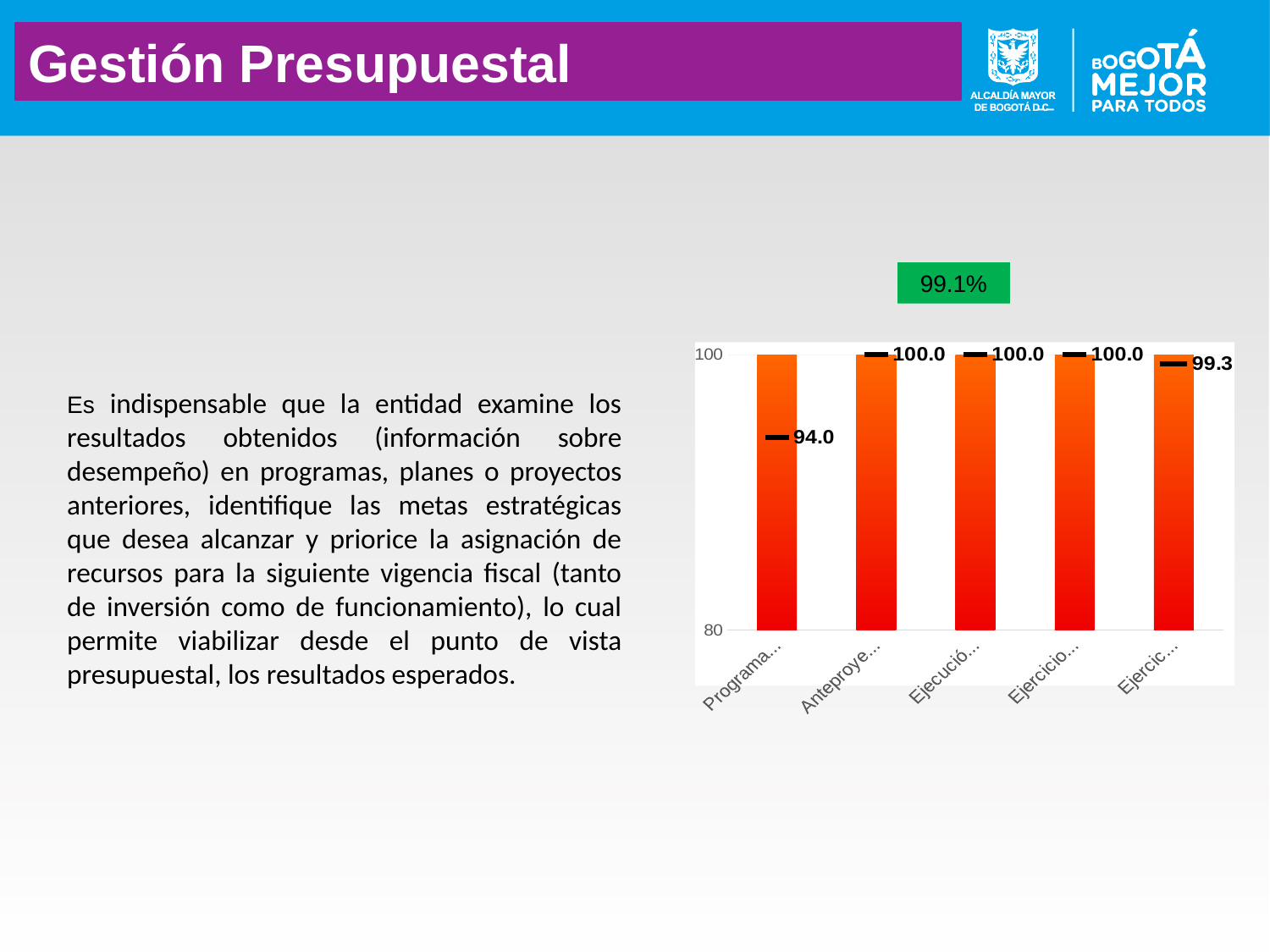
Which bar has the lowest value? the first bar (Programa...) Which is larger, the value of the first bar or the value of the last bar? the last bar What is the lowest value shown on the vertical axis? 80 What is the difference between the value of the fourth bar (100.0) and the last bar (99.3)? 0.7 What percentage is shown in the green box above the chart? 99.1% How many bars reach a value of 100.0? 3 What is the value of the first bar (labelled "Programa...")? 94.0 What is the difference between the value of the second bar (100.0) and the first bar (94.0)? 6.0 What kind of chart is shown on the slide? bar chart How many bars does the chart show? 5 What is the value of the second bar (labelled "Anteproye...")? 100.0 What is the value of the last bar (labelled "Ejercic...")? 99.3